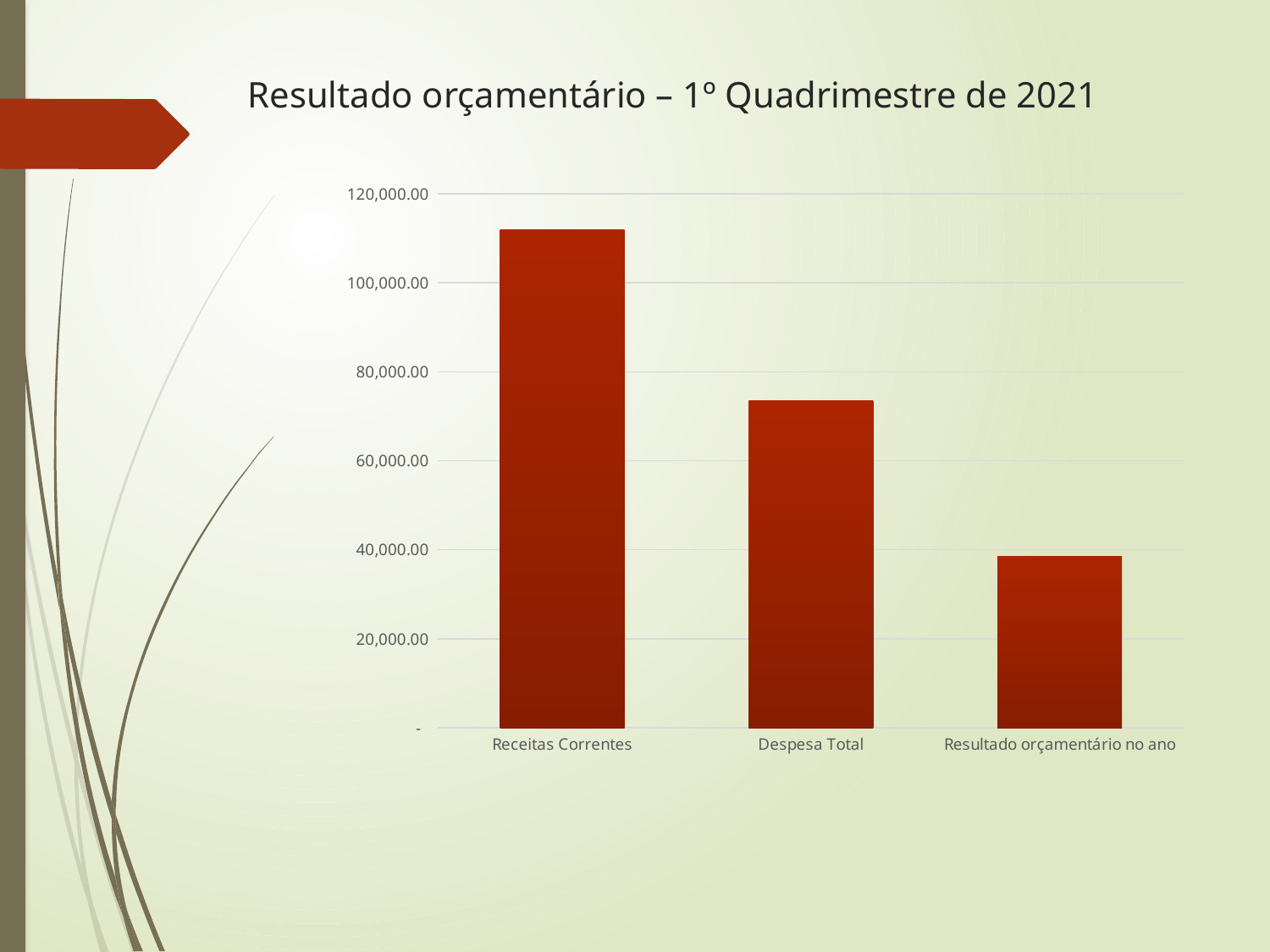
What kind of chart is shown on the slide? bar chart What is the title of the slide containing the chart? Resultado orçamentário – 1º Quadrimestre de 2021 Is the value for Despesa Total greater or less than 60,000.00? greater Which category has the lowest value? Resultado orçamentário no ano Which category has the highest value? Receitas Correntes Do the bar values rise or fall from left to right across the categories? fall Which is larger, the value for Receitas Correntes or the value for Despesa Total? Receitas Correntes Which is larger, the value for Despesa Total or the value for Resultado orçamentário no ano? Despesa Total Is the value for Receitas Correntes greater or less than 100,000.00? greater Is the value for Despesa Total greater or less than 80,000.00? less How many categories are plotted on the chart? 3